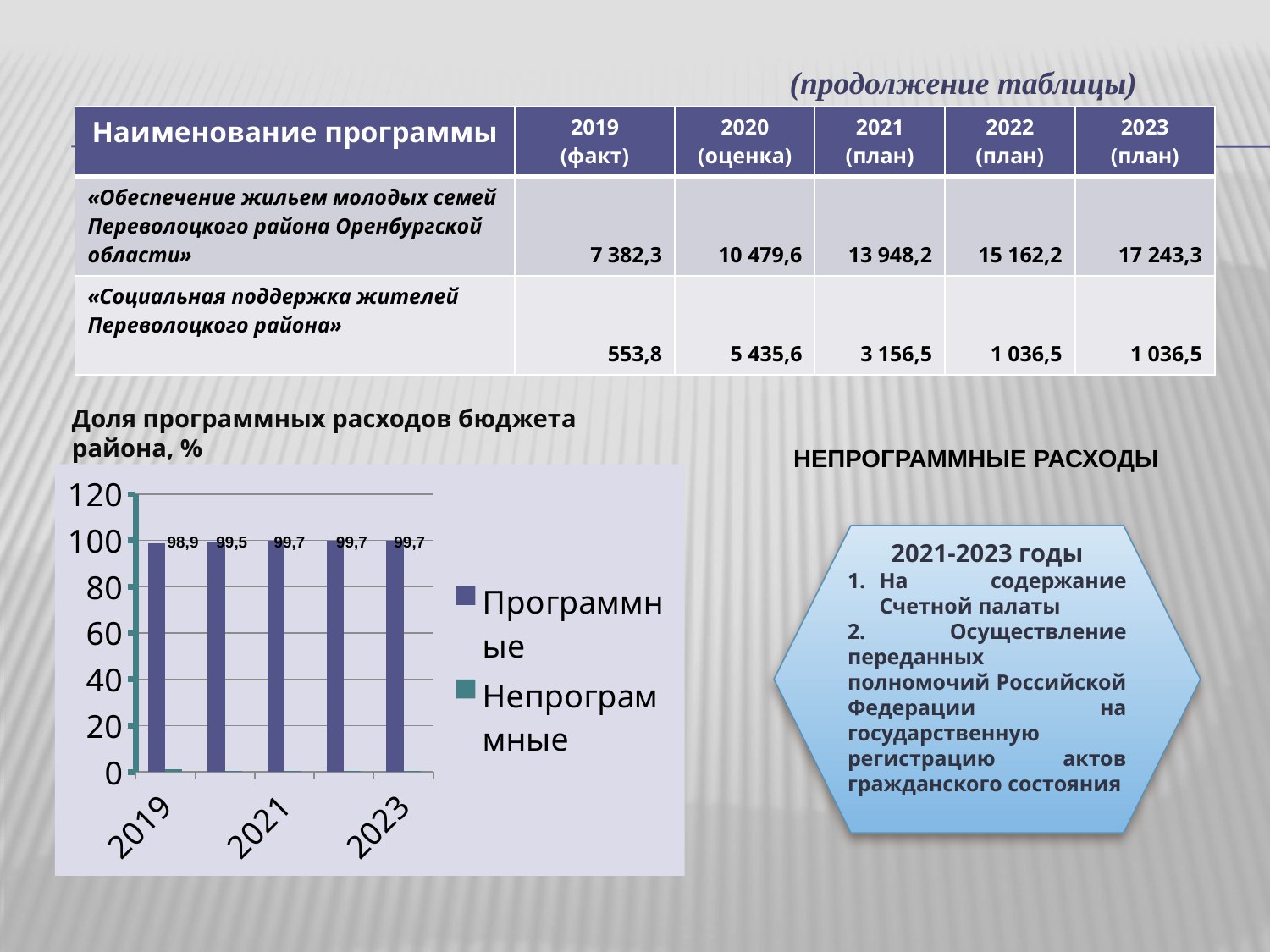
What is the difference between the Программные values for 2021 and 2019? 0,8 What are the two series named in the chart legend? Программные, Непрограммные What type of chart is shown on the slide? bar chart Which is larger, the Программные value for 2019 or for 2021? 2021 What is the value of the Программные series for 2023? 99,7 Is the Программные value for 2019 greater or less than 80? greater Do the Программные values rise or fall from 2019 to 2023? rise Which year has the lowest value for the Программные series? 2019 How many series does the chart legend list? 2 What is the title of the chart? Доля программных расходов бюджета района, % What is the value of the Программные series for 2019? 98,9 What is the value of the Программные series for 2021? 99,7